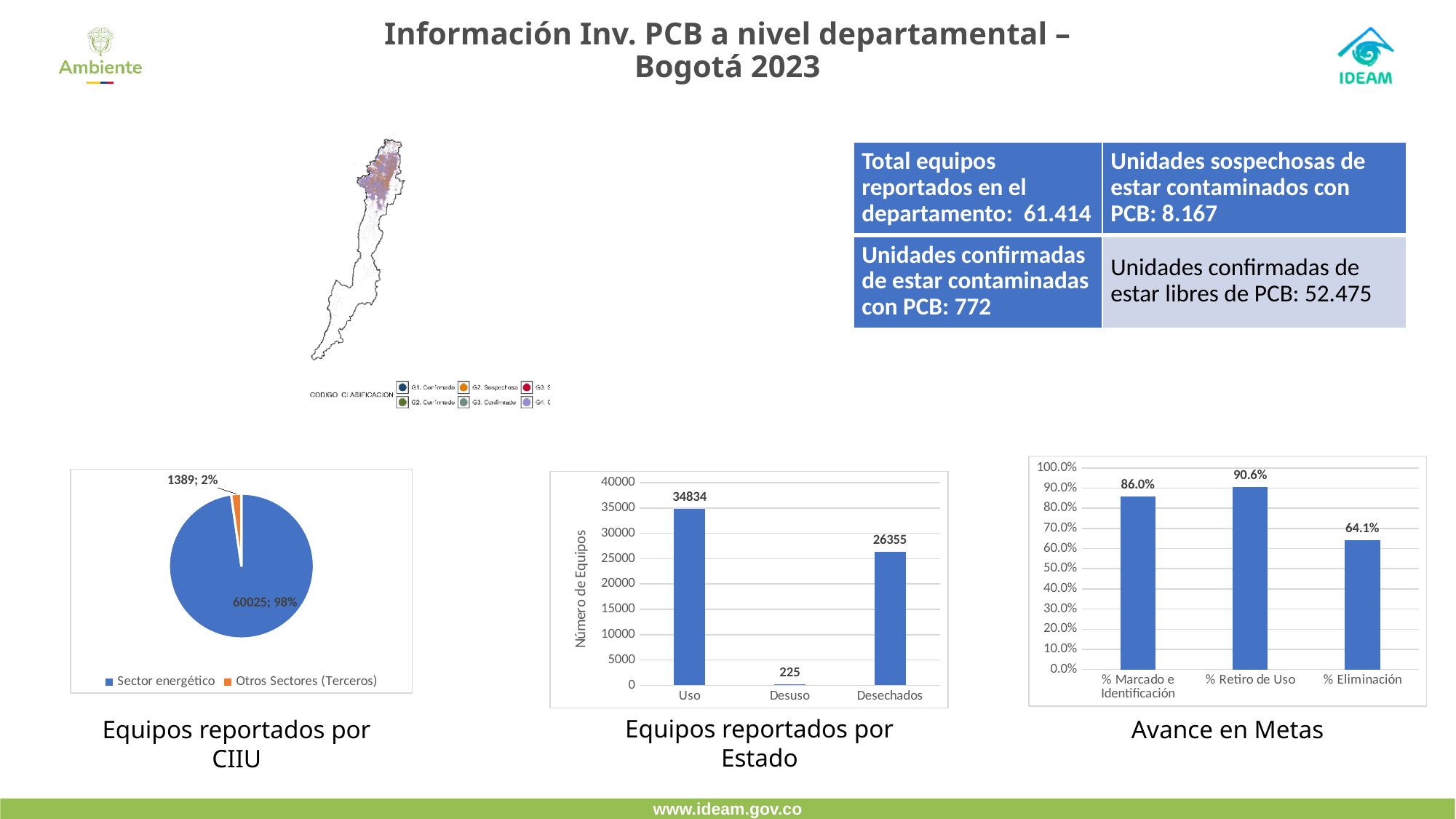
In the 'Equipos reportados por Estado' chart, how many categories are shown on the x axis? 3 In the 'Equipos reportados por Estado' chart, which category has the lowest value? Desuso In the 'Equipos reportados por CIIU' pie chart, what is the value for Sector energético? 60025 In the 'Avance en Metas' chart, what is the value for % Retiro de Uso? 90.6% In the 'Equipos reportados por CIIU' pie chart, what share does Otros Sectores (Terceros) have? 2% In the 'Equipos reportados por Estado' chart, what is the value for Desuso? 225 In the 'Avance en Metas' chart, what is the difference between % Retiro de Uso and % Eliminación? 26.5% What kind of chart is 'Equipos reportados por Estado'? bar chart In the 'Equipos reportados por Estado' chart, what is the value for Uso? 34834 In the 'Avance en Metas' chart, which category has the highest value? % Retiro de Uso In the 'Avance en Metas' chart, which is larger: % Marcado e Identificación or % Eliminación? % Marcado e Identificación In the 'Equipos reportados por Estado' chart, what is the difference between Uso and Desechados? 8479